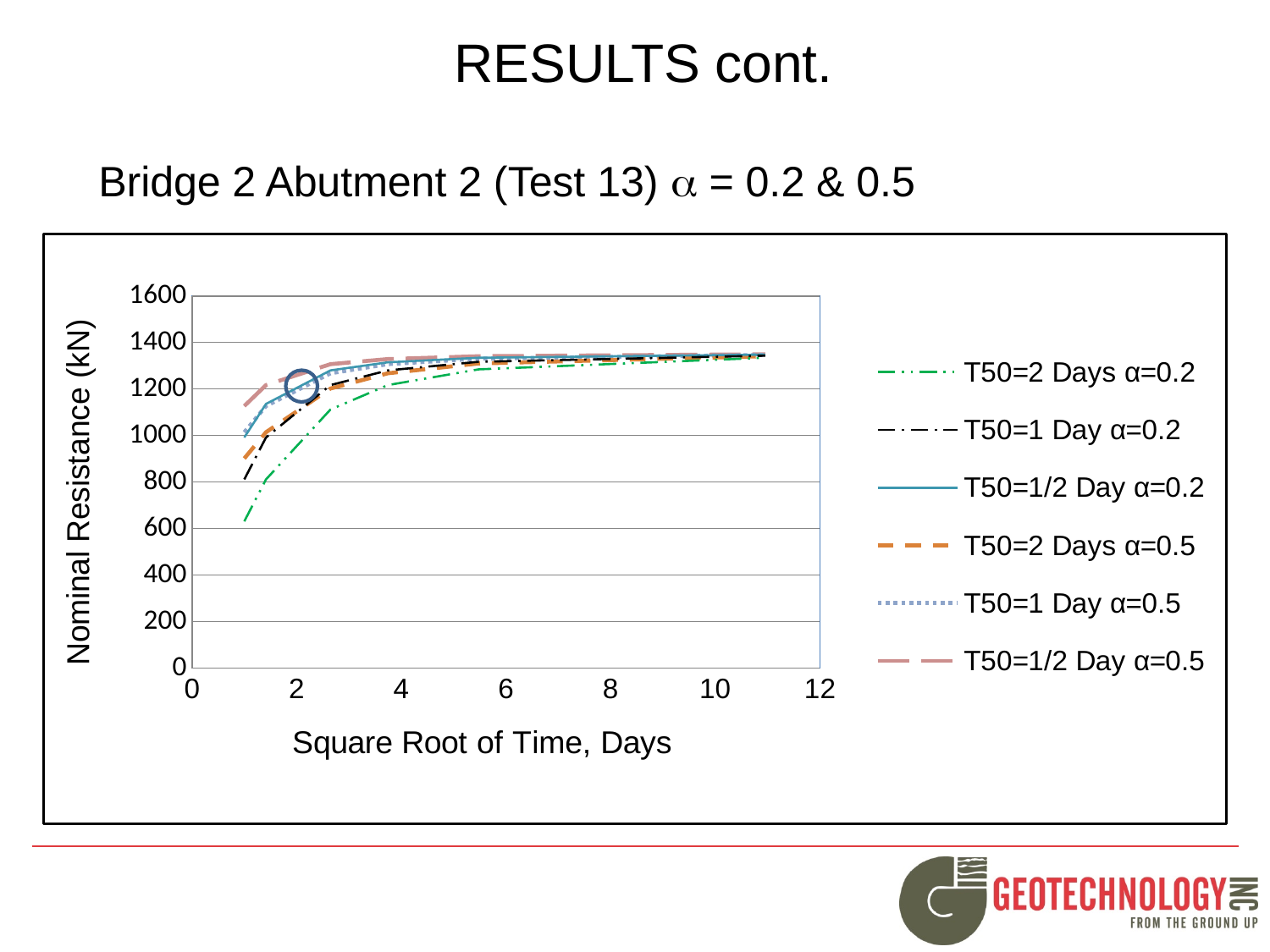
What is the title of the y axis? Nominal Resistance (kN) What kind of chart is shown on the slide? line chart Which series has the highest value at a square root of time of 1 day? T50=1/2 Day α=0.5 Is the value for T50=1/2 Day α=0.5 at a square root of time of 1 day greater or less than 1000? greater Are the values of all series at a square root of time of 10 days greater or less than 1200? greater How many series does the legend list? 6 Which series has the lowest value at a square root of time of 1 day? T50=2 Days α=0.2 At a square root of time of 1 day, which is larger: the value for T50=1/2 Day α=0.5 or the value for T50=2 Days α=0.2? T50=1/2 Day α=0.5 Do the values of the T50=2 Days α=0.2 series rise or fall as the square root of time increases? rise What is the title of the x axis? Square Root of Time, Days Is the value for T50=1 Day α=0.2 at a square root of time of 1 day greater or less than 1000? less